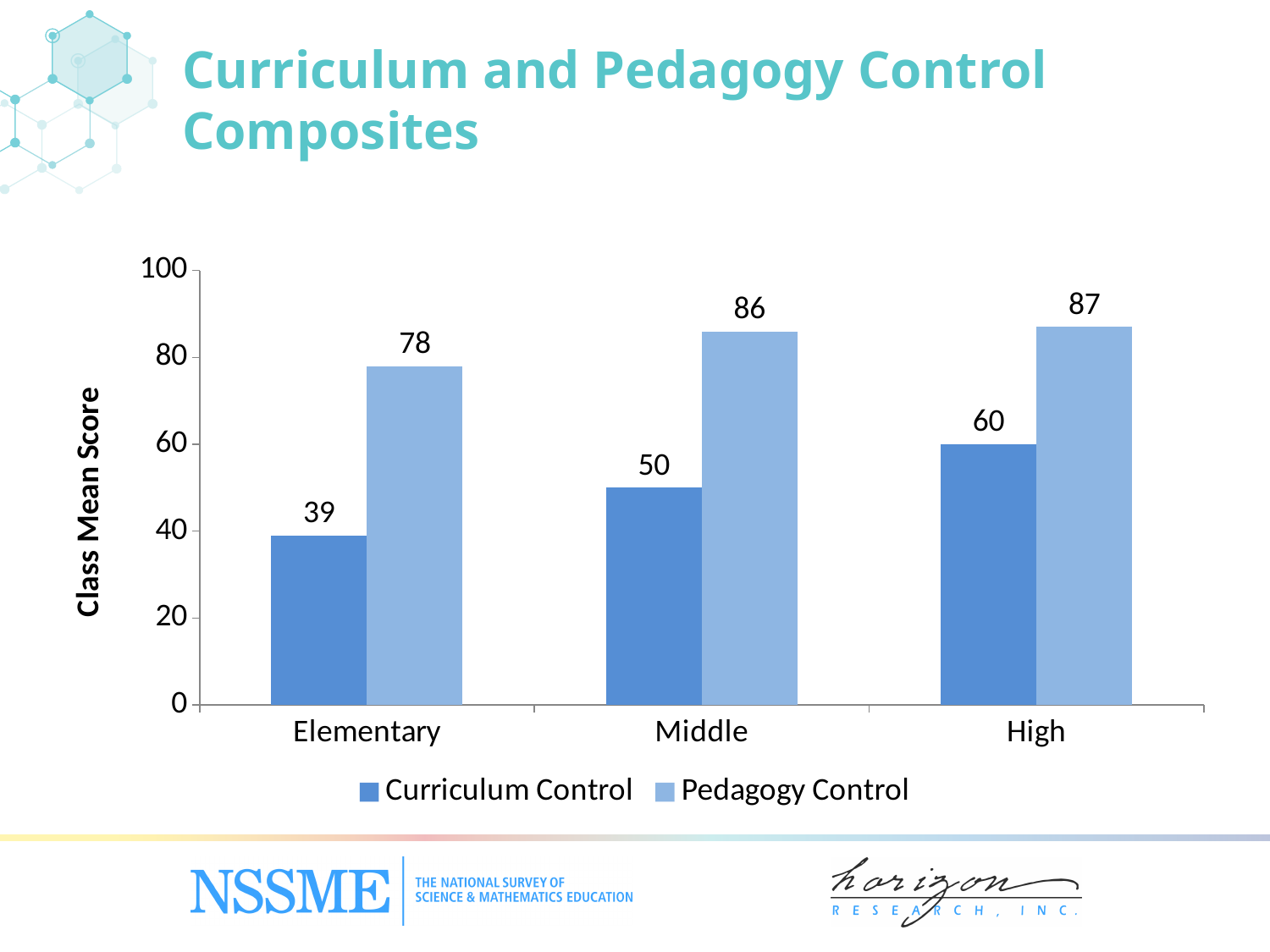
What is the difference between the Curriculum Control scores for High and Middle? 10 Which is larger for Middle: Curriculum Control or Pedagogy Control? Pedagogy Control What is the Curriculum Control value for High? 60 Which grade level has the lowest Curriculum Control score? Elementary What is the Curriculum Control value for Elementary? 39 Which grade level has the highest Pedagogy Control score? High What is the difference between the Pedagogy Control and Curriculum Control scores for Elementary? 39 What is the Pedagogy Control value for Middle? 86 What is the label of the vertical axis? Class Mean Score How many series does the legend list? 2 What kind of chart is shown on the slide? Bar chart How many grade-level categories are shown on the x axis? 3